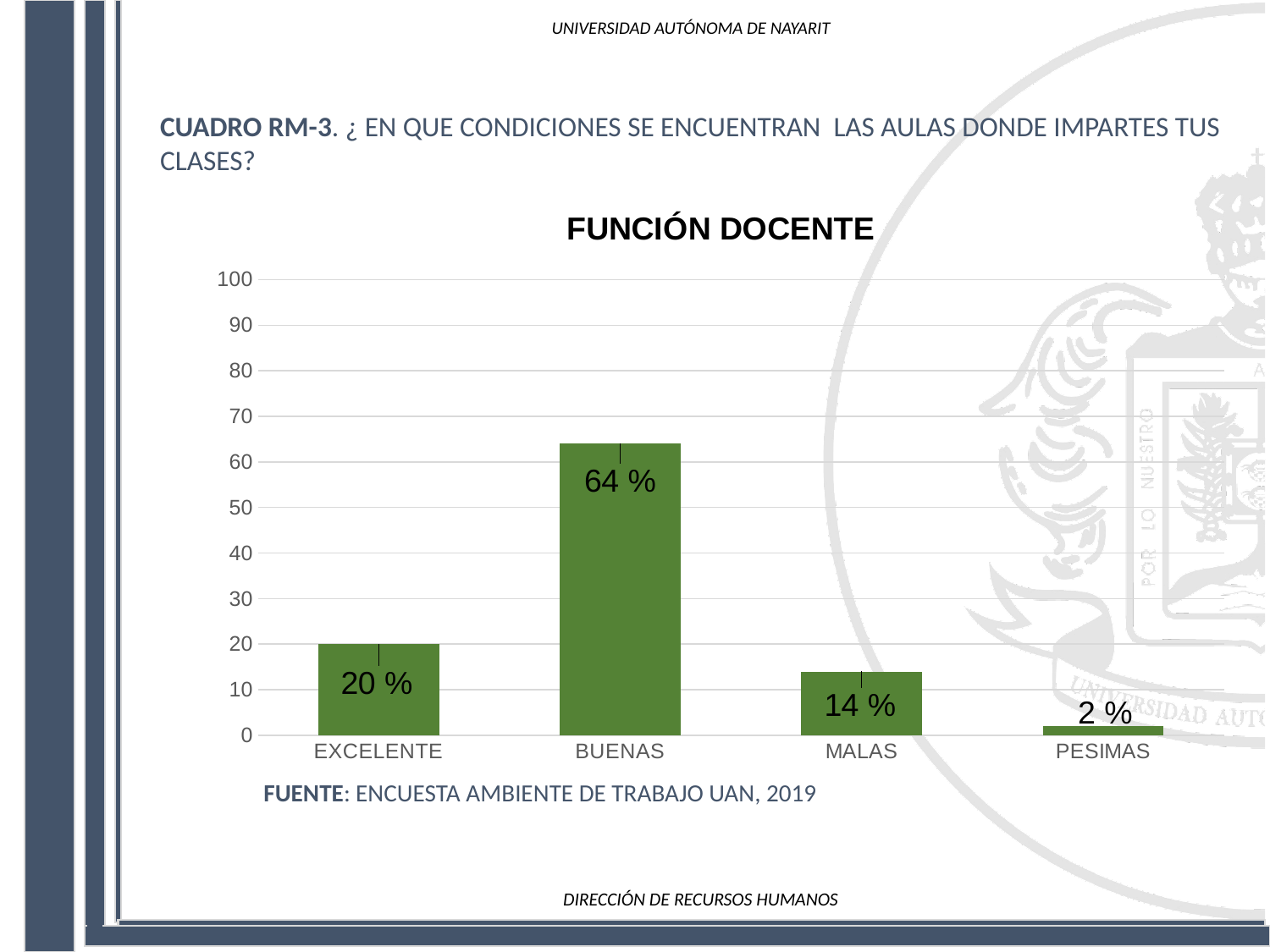
What is the value for MALAS? 14 % Which category has the lowest value? PESIMAS What kind of chart is shown on the slide? bar chart What is the value for PESIMAS? 2 % Which category has the highest value? BUENAS What is the difference between the values for BUENAS and EXCELENTE? 44 % What is the title of the chart? FUNCIÓN DOCENTE What is the value for BUENAS? 64 % Is the value for BUENAS greater or less than 50? greater Which is larger, the value for EXCELENTE or the value for MALAS? EXCELENTE What is the value for EXCELENTE? 20 % How many categories are shown on the x axis? 4